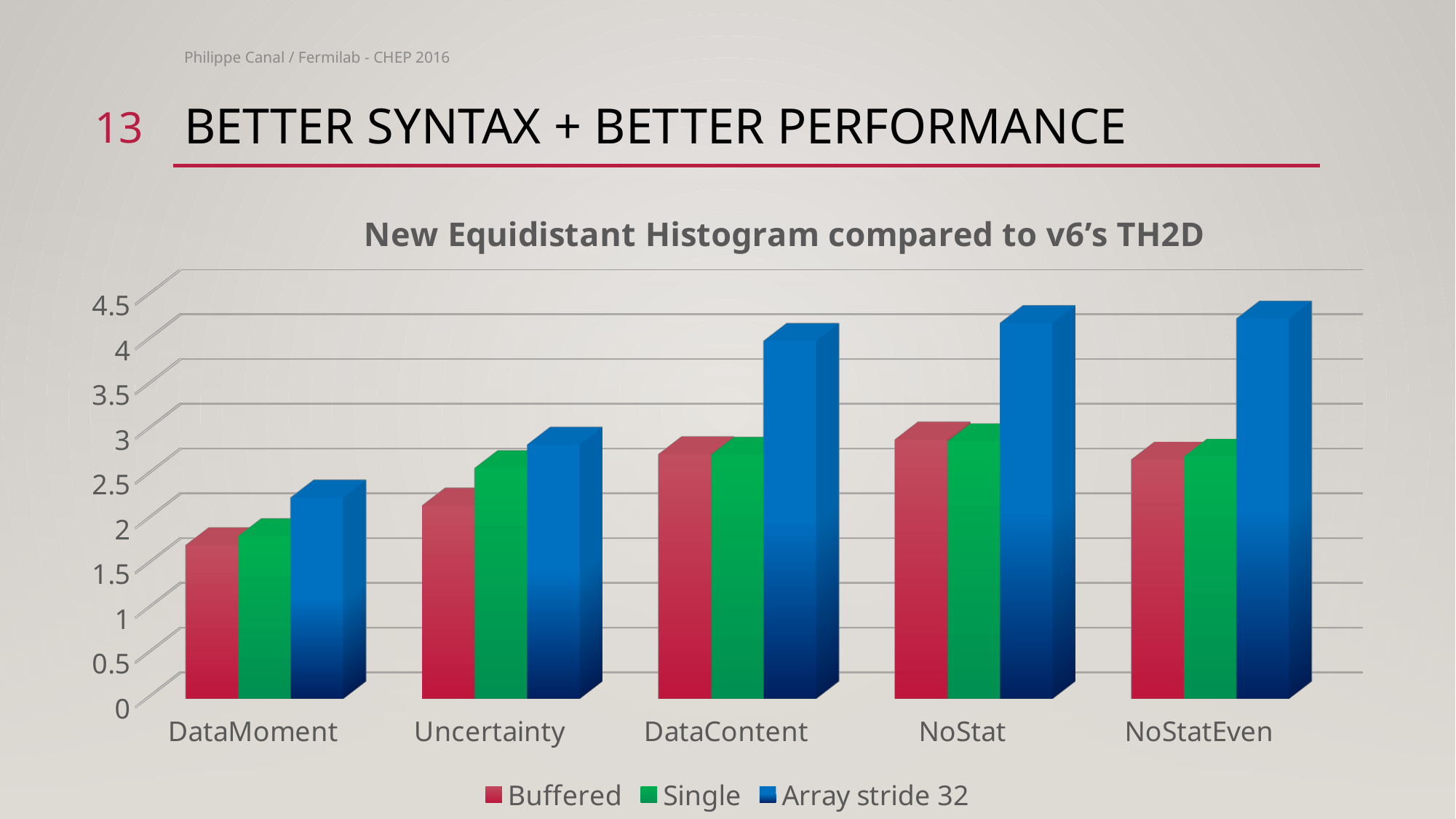
Which colour represents the Array stride 32 series? blue Is the Array stride 32 value for DataContent greater or less than 3.5? greater Is the Array stride 32 value for DataMoment greater or less than 3? less How many series does the legend list? 3 Which category has the lowest value for the Buffered series? DataMoment Which category has the lowest value for the Array stride 32 series? DataMoment For the Single series, which is larger: Uncertainty or DataMoment? Uncertainty What is the title of the chart? New Equidistant Histogram compared to v6's TH2D For DataContent, which is larger: the Array stride 32 value or the Buffered value? Array stride 32 What kind of chart is shown on the slide? bar chart Is the Buffered value for Uncertainty greater or less than 3? less How many categories are shown on the x axis? 5